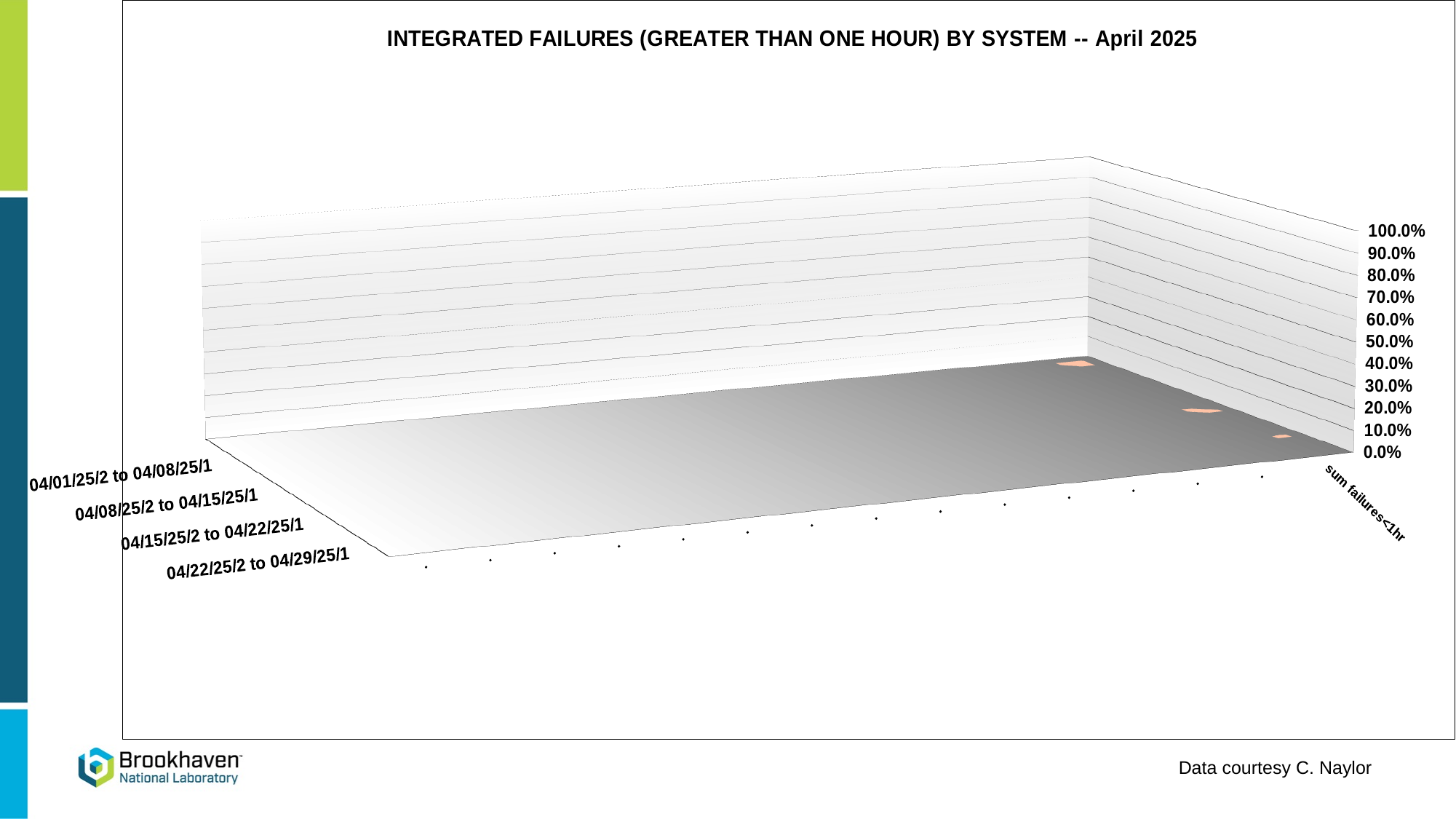
What is the first date-range category listed on the chart? 04/01/25/2 to 04/08/25/1 What is the last date-range category listed on the chart? 04/22/25/2 to 04/29/25/1 What is the title of the chart? INTEGRATED FAILURES (GREATER THAN ONE HOUR) BY SYSTEM -- April 2025 How many date-range categories are labelled along the left axis of the chart? 4 What is the highest value shown on the vertical axis of the chart? 100.0% Which month does the chart title say the data covers? April 2025